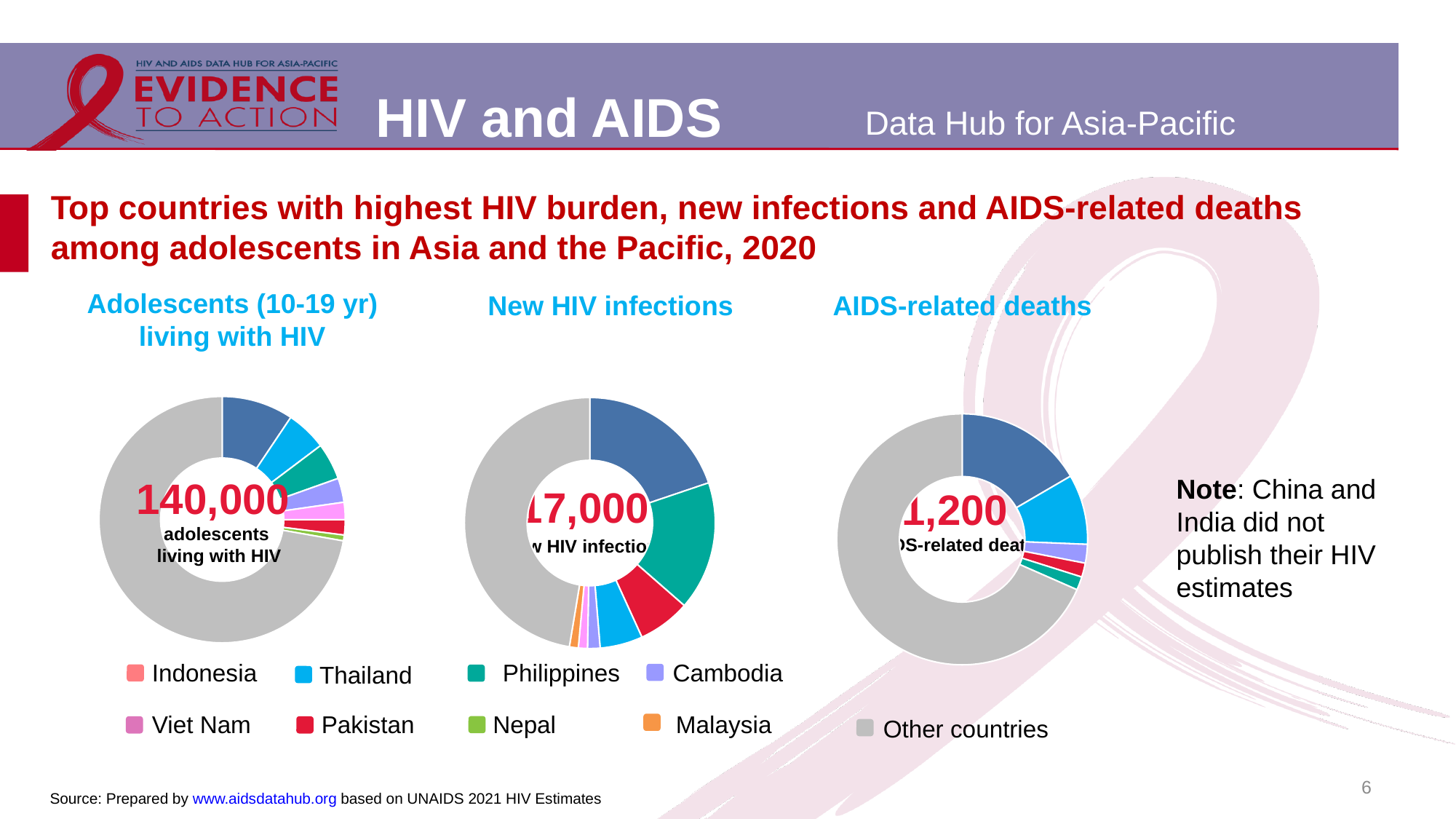
In the 'Adolescents (10-19 yr) living with HIV' chart, which is larger: the slice for Other countries or the slice for Thailand? Other countries How many entries does the shared legend list? 9 Which two countries does the note say did not publish their HIV estimates? China and India In the 'New HIV infections' chart, what total is printed in the centre? 17,000 In the 'AIDS-related deaths' chart, which legend category has the largest slice? Other countries In the 'Adolescents (10-19 yr) living with HIV' chart, which legend category has the largest slice? Other countries What kind of chart is used on this slide? Pie chart (donut) In the 'Adolescents (10-19 yr) living with HIV' chart, what total is printed in the centre? 140,000 How many charts are shown on the slide? 3 In the 'AIDS-related deaths' chart, what total is printed in the centre? 1,200 What is the title of the slide's chart section? Top countries with highest HIV burden, new infections and AIDS-related deaths among adolescents in Asia and the Pacific, 2020 In the 'New HIV infections' chart, which legend category has the largest slice? Other countries